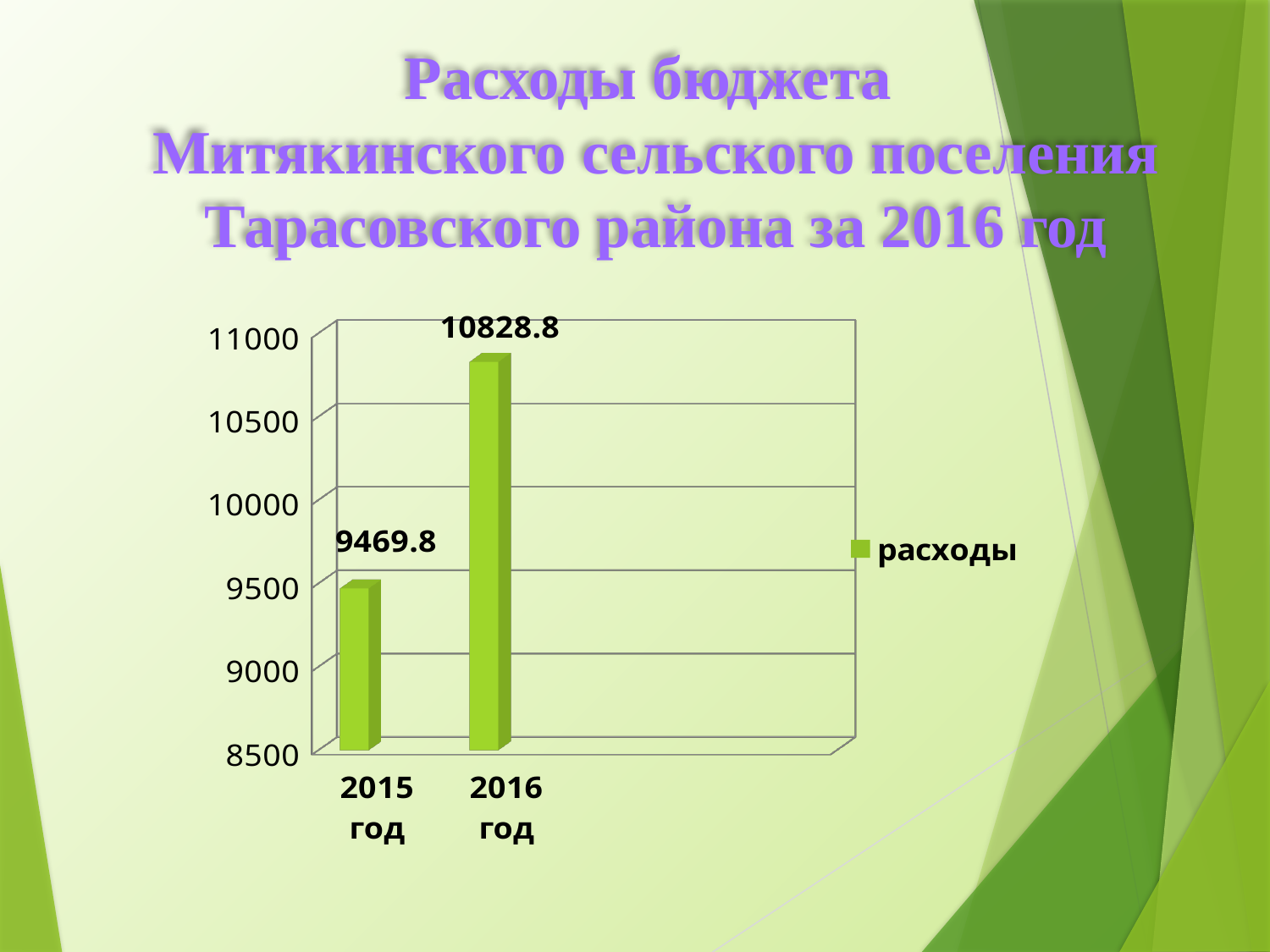
How many series does the legend list? 1 What is the value for 2015 год? 9469.8 Is the value for 2016 год greater or less than 10500? greater What is the name of the series in the legend? расходы Which year has the highest value? 2016 год How many categories are shown on the x axis? 2 What is the value for 2016 год? 10828.8 Is the value for 2015 год greater or less than 9500? less Which year has the lowest value? 2015 год Which is larger, the value for 2015 год or 2016 год? 2016 год What kind of chart is shown on the slide? bar chart What is the difference between the values for 2016 год and 2015 год? 1359